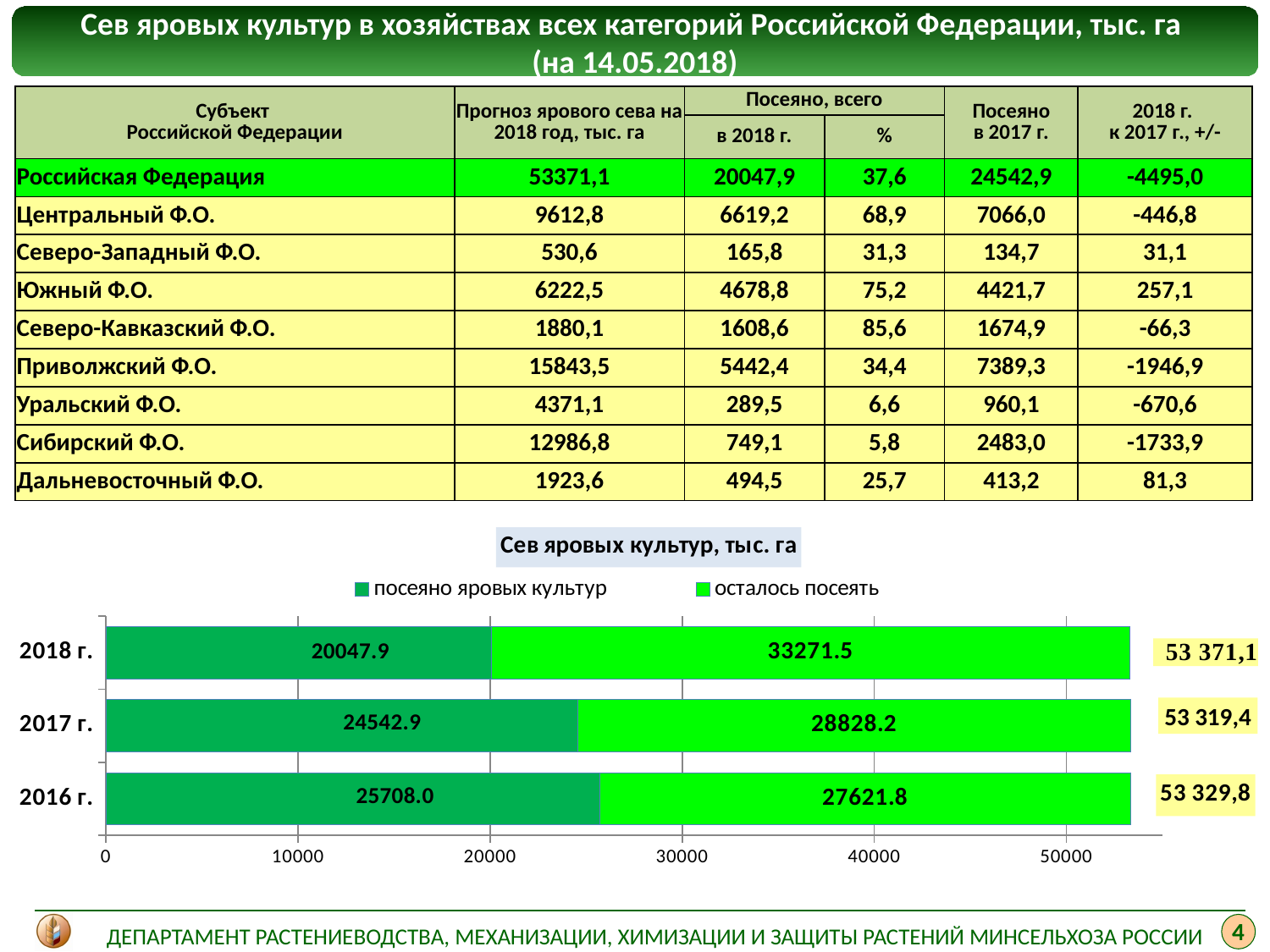
In the chart, what is the value of 'посеяно яровых культур' for 2018 г.? 20047.9 In the chart, what is the value of 'посеяно яровых культур' for 2016 г.? 25708.0 In the chart, what is the value of 'осталось посеять' for 2017 г.? 28828.2 What is the title of the chart on the slide? Сев яровых культур, тыс. га How many years (categories) are plotted in the chart? 3 In the chart, what is the difference between 'осталось посеять' and 'посеяно яровых культур' for 2018 г.? 13223.6 In the chart, which year has the lowest value for 'осталось посеять'? 2016 г. In the chart, which year has the highest value for 'посеяно яровых культур'? 2016 г. In the chart, which is larger for 2017 г.: 'посеяно яровых культур' or 'осталось посеять'? осталось посеять In the chart, what is the total of the stacked bar for 2017 г.? 53371.1 What kind of chart is shown on the slide? stacked bar chart How many series does the chart legend list? 2